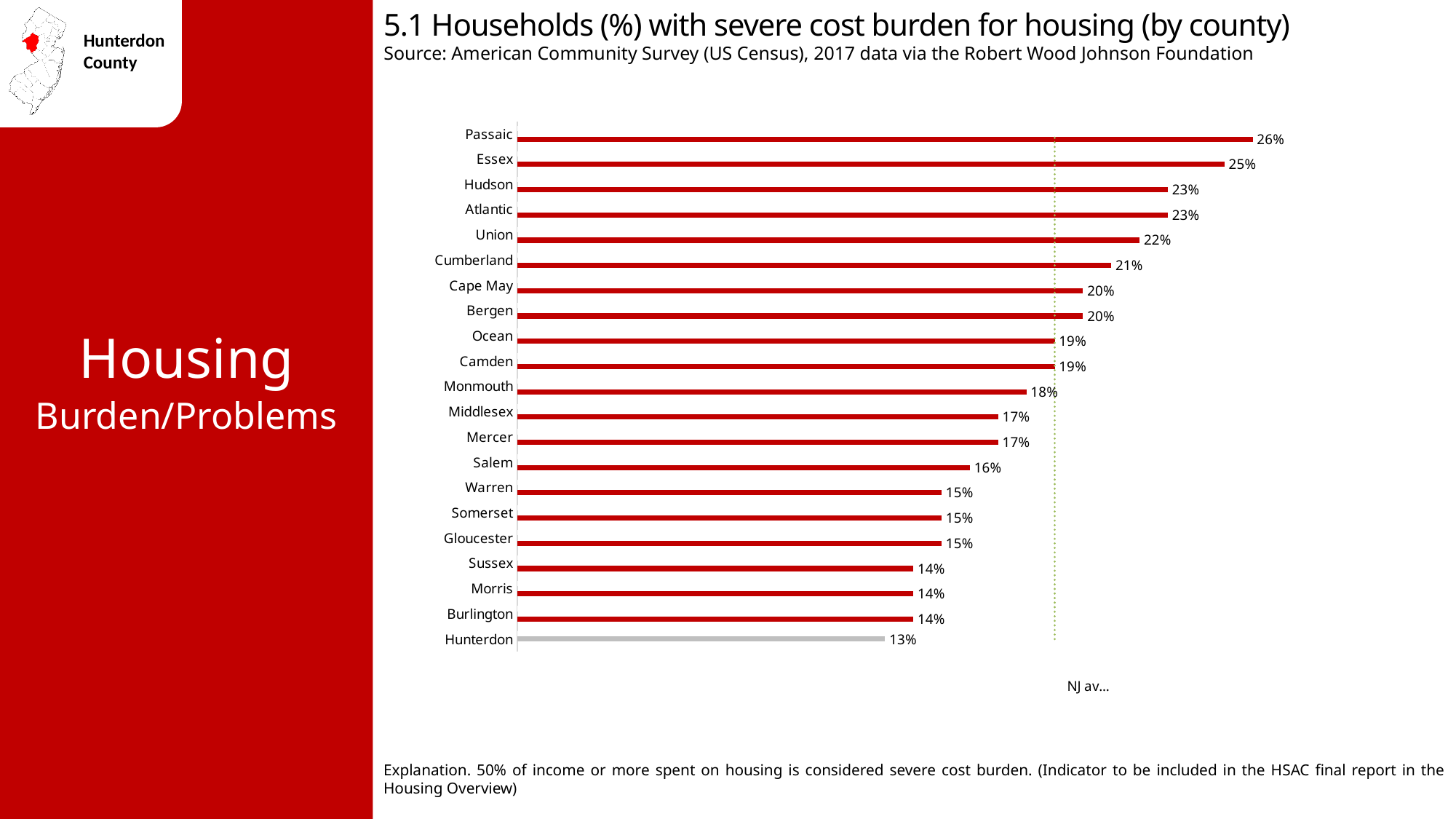
Which county has the highest percentage of households with severe housing cost burden? Passaic What is the difference in percentage points between Passaic and Hunterdon? 13 Which county's bar is shown in grey rather than red? Hunterdon What is the difference in percentage points between Essex and Union? 3 How many counties are shown in the chart? 21 Which county has the lowest percentage of households with severe housing cost burden? Hunterdon Which has a higher value, Hudson or Bergen? Hudson What is the value shown for Hunterdon? 13% What percentage is shown for Cumberland? 21% Which has a higher value, Salem or Sussex? Salem What percentage of households in Passaic have a severe housing cost burden? 26% What type of chart is shown on the slide? Bar chart